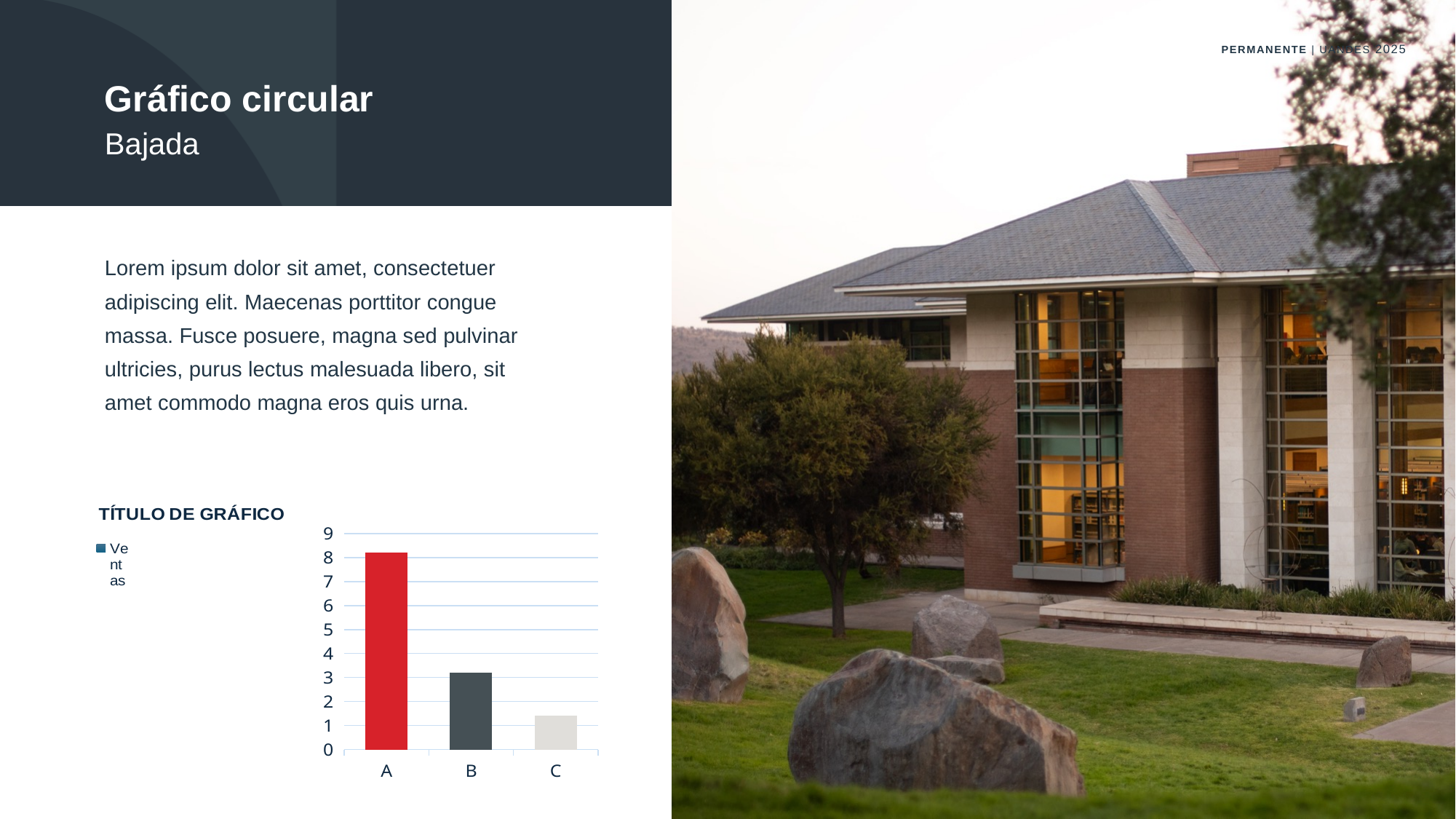
What kind of chart is shown on the slide? bar chart Is the value for C greater or less than 2? less Do the values rise or fall from A to C along the x axis? fall How many series does the chart legend list? 1 Which category has the lowest value in the chart? C How many categories are plotted on the x axis of the chart? 3 Which is larger, the value for B or the value for C? B Which is larger, the value for A or the value for B? A What is the title of the chart? TÍTULO DE GRÁFICO Which category has the highest value in the chart? A Is the value for B greater or less than 4? less